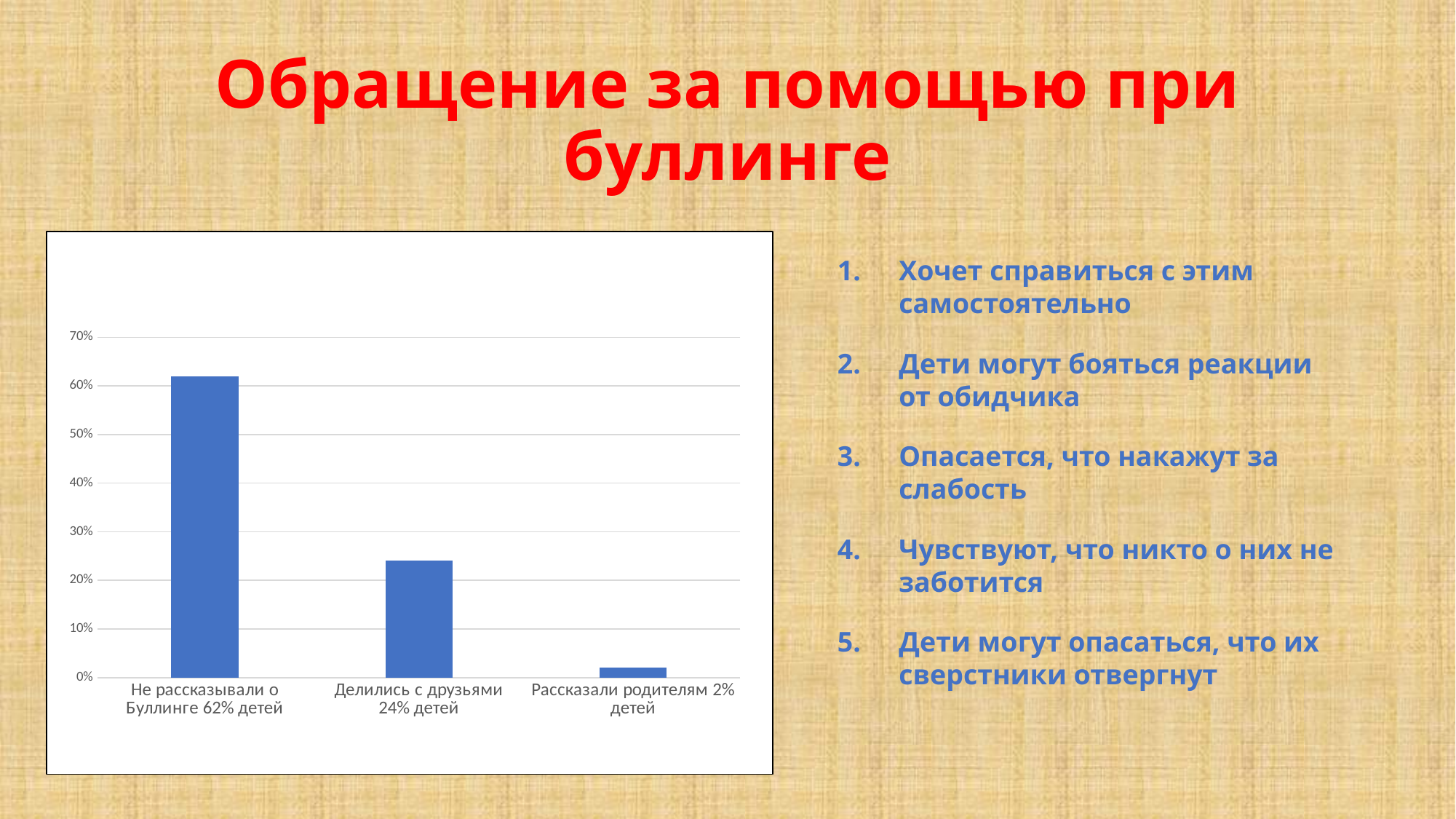
Which category has the lowest value? Рассказали родителям What percentage of children is given for the category "Делились с друзьями"? 24% What is the difference between the values for "Не рассказывали о Буллинге" and "Делились с друзьями"? 38% What percentage of children is given for the category "Не рассказывали о Буллинге"? 62% Is the value for "Не рассказывали о Буллинге" greater or less than 50%? greater Do the bar values rise or fall from left to right along the x axis? fall How many categories does the chart show? 3 Which category has the highest value? Не рассказывали о Буллинге What is the difference between the values for "Делились с друзьями" and "Рассказали родителям"? 22% What kind of chart is shown on the slide? bar chart Which is larger: the value for "Делились с друзьями" or the value for "Рассказали родителям"? Делились с друзьями What percentage of children is given for the category "Рассказали родителям"? 2%